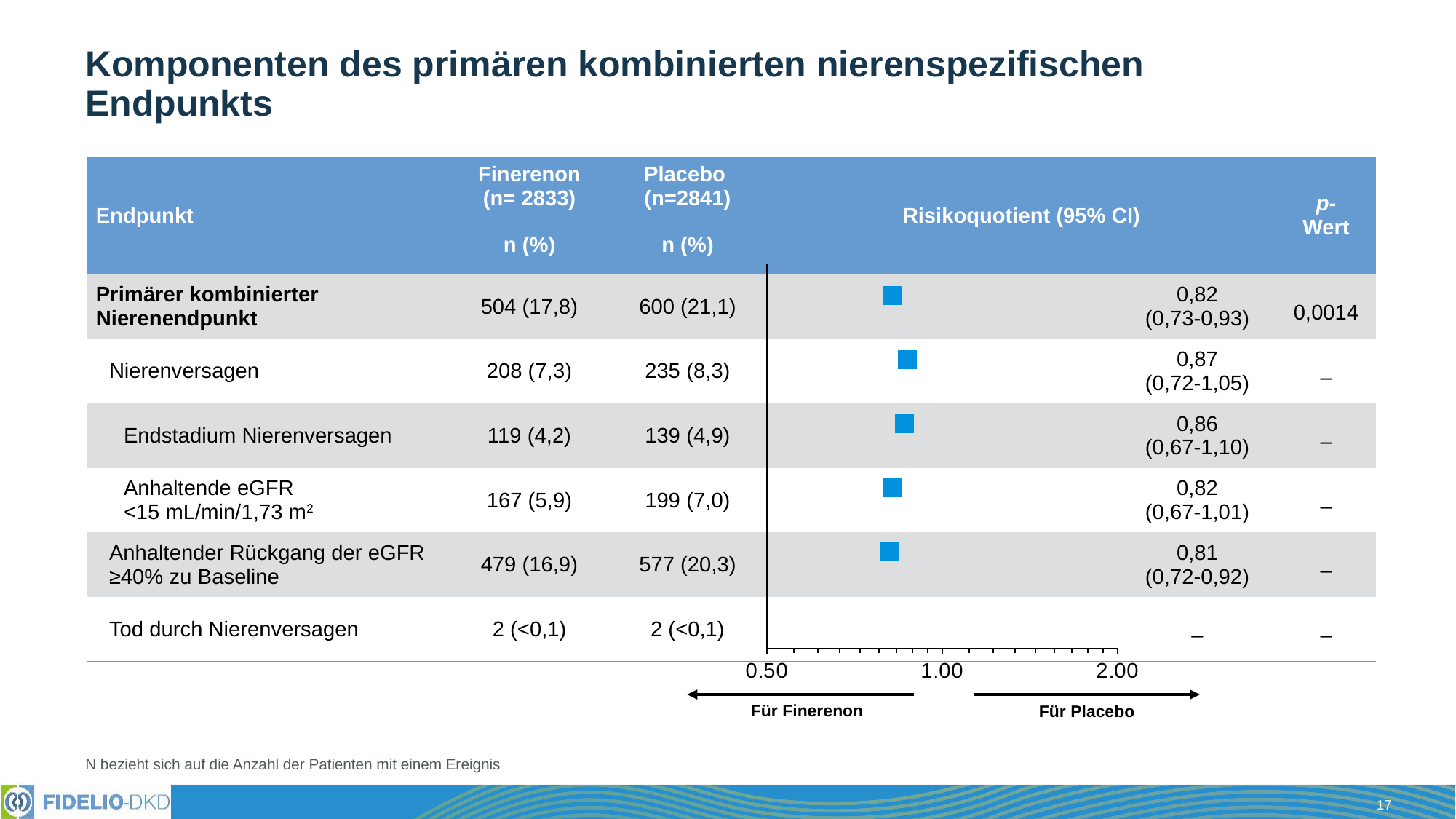
What kind of chart is shown in the Risikoquotient (95% CI) column? forest plot How many endpoints have a hazard ratio point plotted on the forest plot? 5 Which endpoint has the lowest plotted hazard ratio? Anhaltender Rückgang der eGFR ≥40% zu Baseline What is the 95% CI shown for the Primärer kombinierter Nierenendpunkt hazard ratio? (0,73-0,93) Is the plotted hazard ratio for Endstadium Nierenversagen greater or less than 1.00? less Which endpoint has the highest plotted hazard ratio? Nierenversagen What is the difference between the hazard ratios for Nierenversagen and Anhaltender Rückgang der eGFR ≥40% zu Baseline? 0,06 What is the hazard ratio (Risikoquotient) plotted for Primärer kombinierter Nierenendpunkt? 0,82 What is the hazard ratio (Risikoquotient) plotted for Anhaltender Rückgang der eGFR ≥40% zu Baseline? 0,81 What is the hazard ratio (Risikoquotient) plotted for Nierenversagen? 0,87 What is the hazard ratio (Risikoquotient) plotted for Endstadium Nierenversagen? 0,86 What is the p-value shown for the Primärer kombinierter Nierenendpunkt? 0,0014